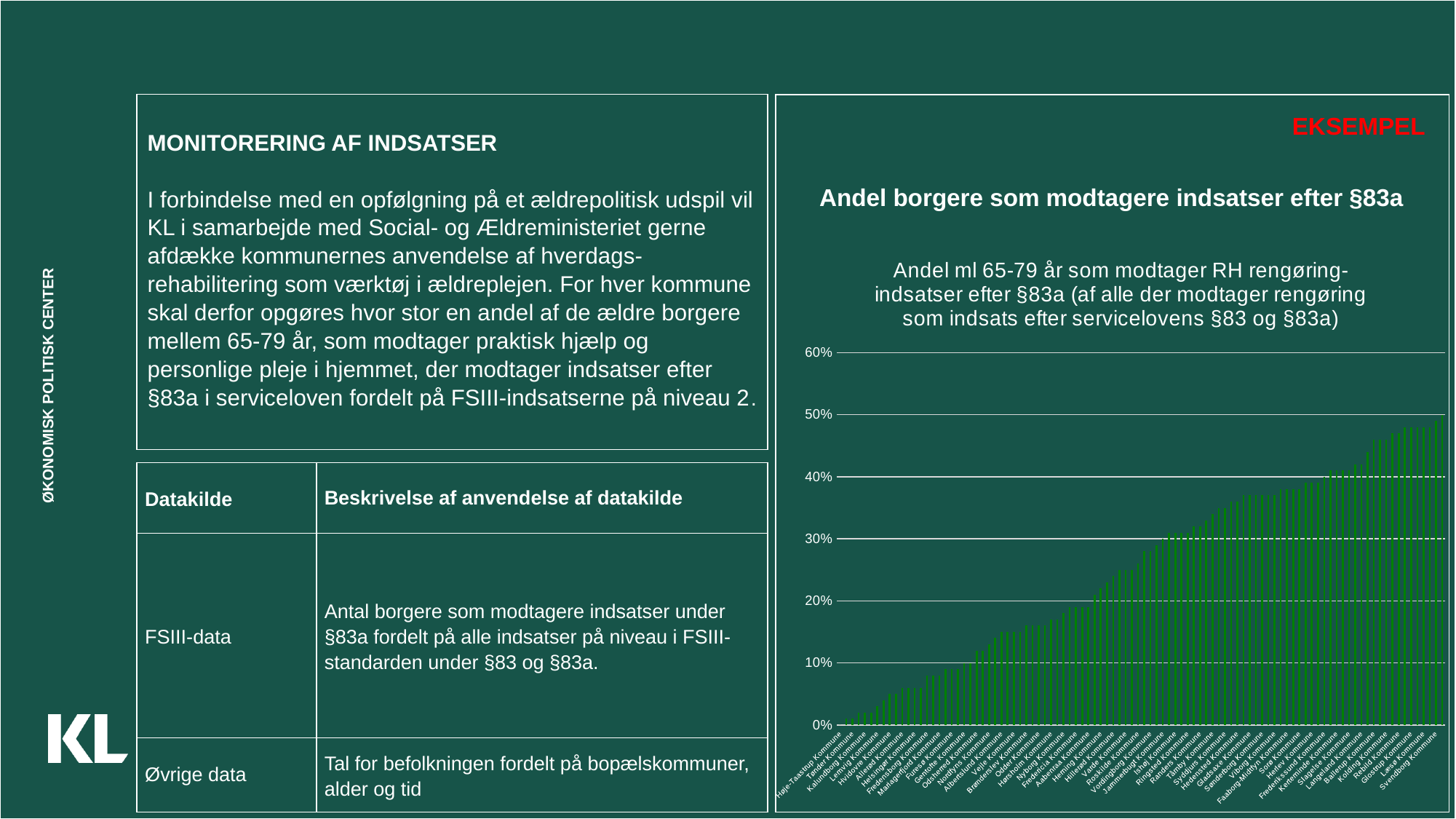
What is the title of the chart on the right side of the slide? Andel borgere som modtagere indsatser efter §83a Which municipality has the lowest value in the chart? Høje-Taastrup Kommune Is the value of the tallest bar greater or less than 60%? less Which has the larger value, Svendborg Kommune or Høje-Taastrup Kommune? Svendborg Kommune Do the bar values rise or fall from left to right along the x axis? rise What is the highest percentage tick shown on the y axis? 60% Is the value of the tallest bar greater or less than 40%? greater What kind of chart is shown on the slide? bar chart Is the value of the leftmost bar greater or less than 10%? less